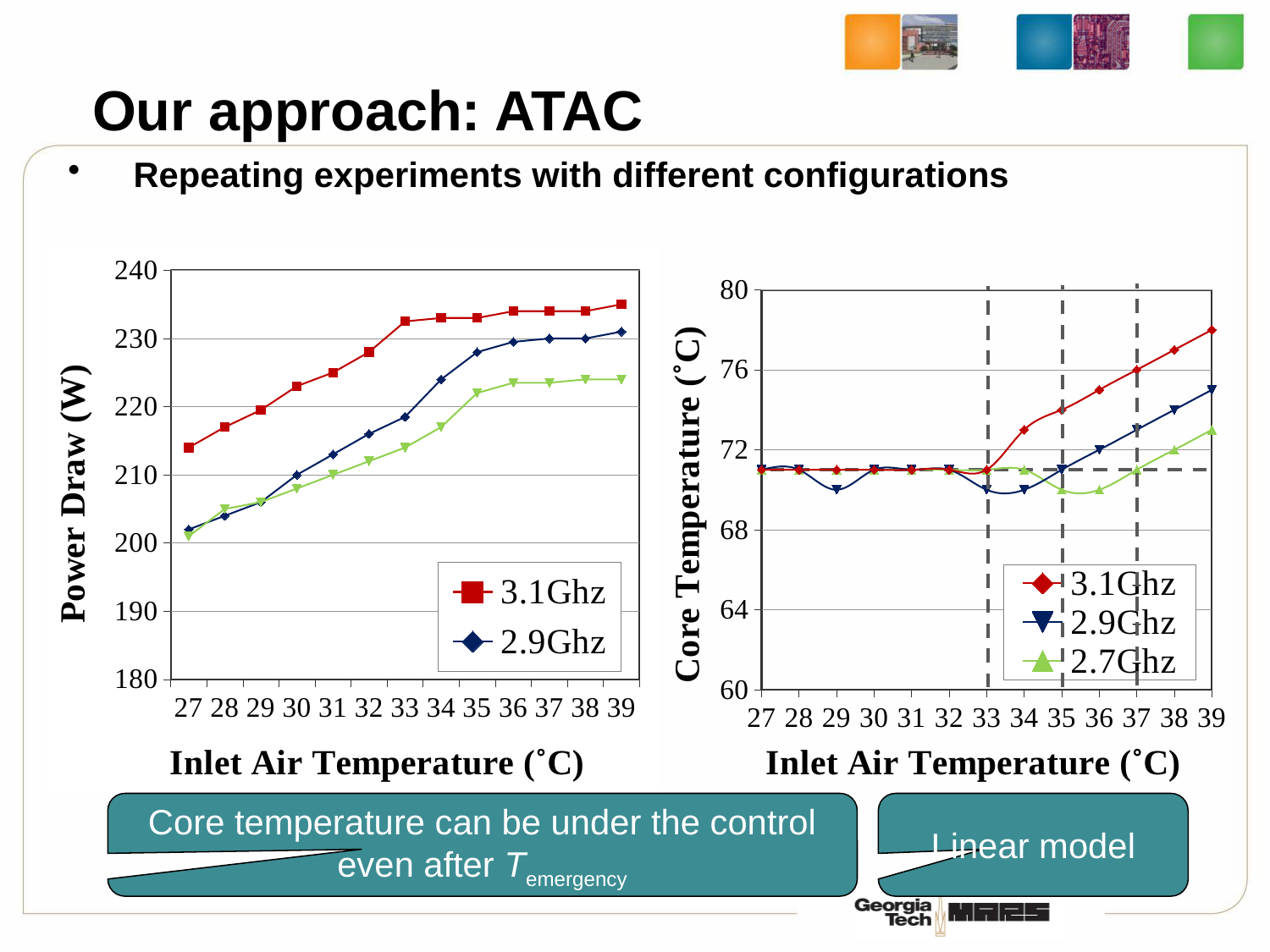
What type of chart is the left chart (Power Draw)? line chart In the left chart (Power Draw), is the 3.1Ghz value at 27 °C greater or less than 210? greater In the left chart (Power Draw), is the 3.1Ghz value at 39 °C greater or less than 230? greater What is the x-axis title of the right chart? Inlet Air Temperature (˚C) In the right chart (Core Temperature), is the 2.7Ghz value at 39 °C greater or less than 76? less In the left chart (Power Draw), does the 3.1Ghz series generally rise or fall as inlet air temperature increases? rise In the left chart (Power Draw), at 39 °C, which series has the higher power draw, 3.1Ghz or 2.9Ghz? 3.1Ghz In the right chart (Core Temperature), how many series does the legend list? 3 In the left chart (Power Draw), how many series does the legend list? 2 In the left chart (Power Draw), how many inlet air temperature values are plotted along the x axis? 13